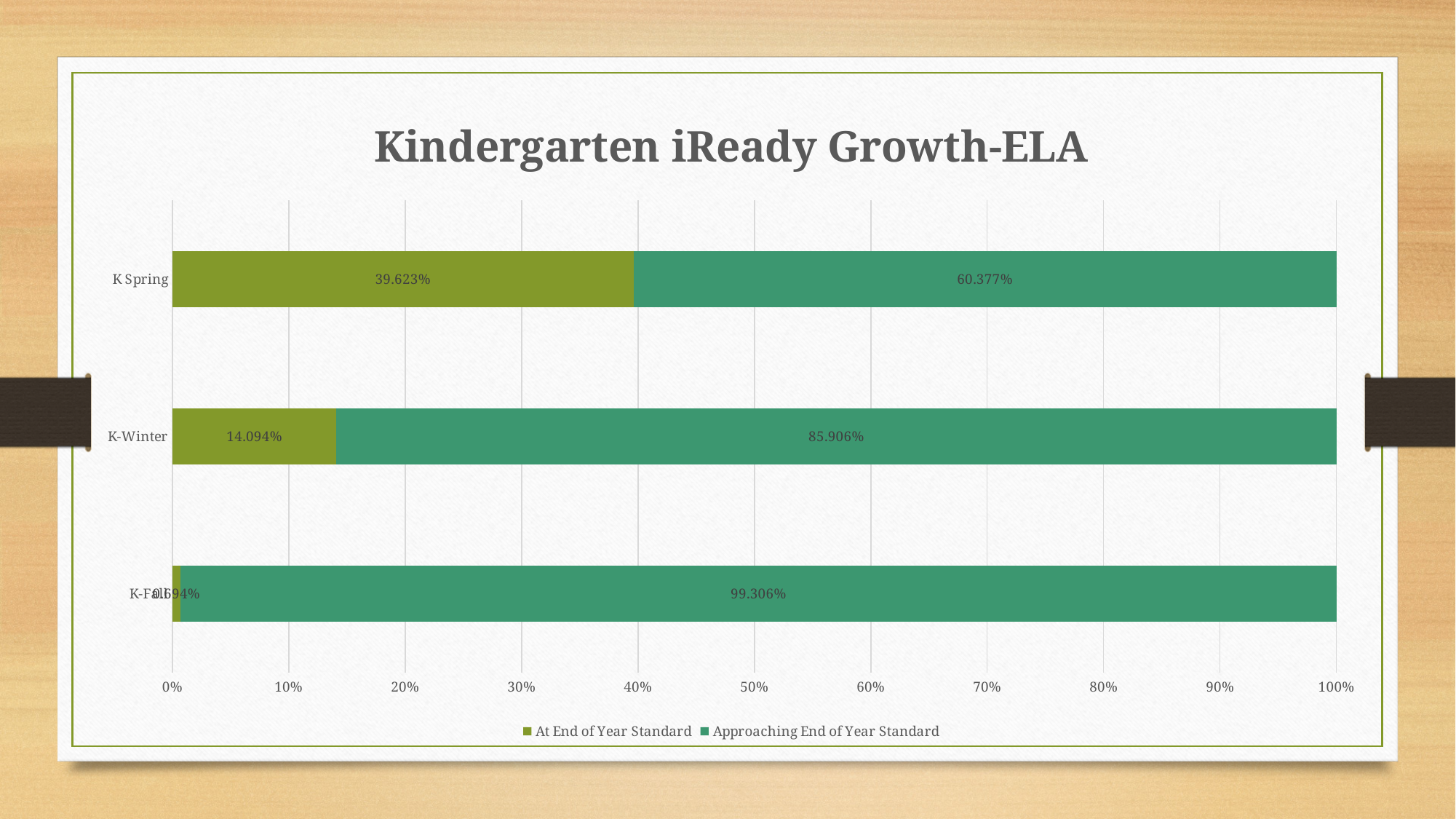
Which category has the lowest Approaching End of Year Standard value? K Spring What is the value for Approaching End of Year Standard for K-Fall? 99.306% What is the difference between the At End of Year Standard values for K Spring and K-Winter? 25.529% What is the value for At End of Year Standard for K Spring? 39.623% How many series does the legend list? 2 Is the At End of Year Standard value for K-Fall greater or less than 10%? less What is the value for At End of Year Standard for K-Winter? 14.094% Which category has the highest At End of Year Standard value? K Spring What kind of chart is shown on the slide? Stacked bar chart Which is larger: the Approaching End of Year Standard value for K-Winter or for K Spring? K-Winter How many categories are shown on the chart? 3 What is the value for Approaching End of Year Standard for K-Winter? 85.906%